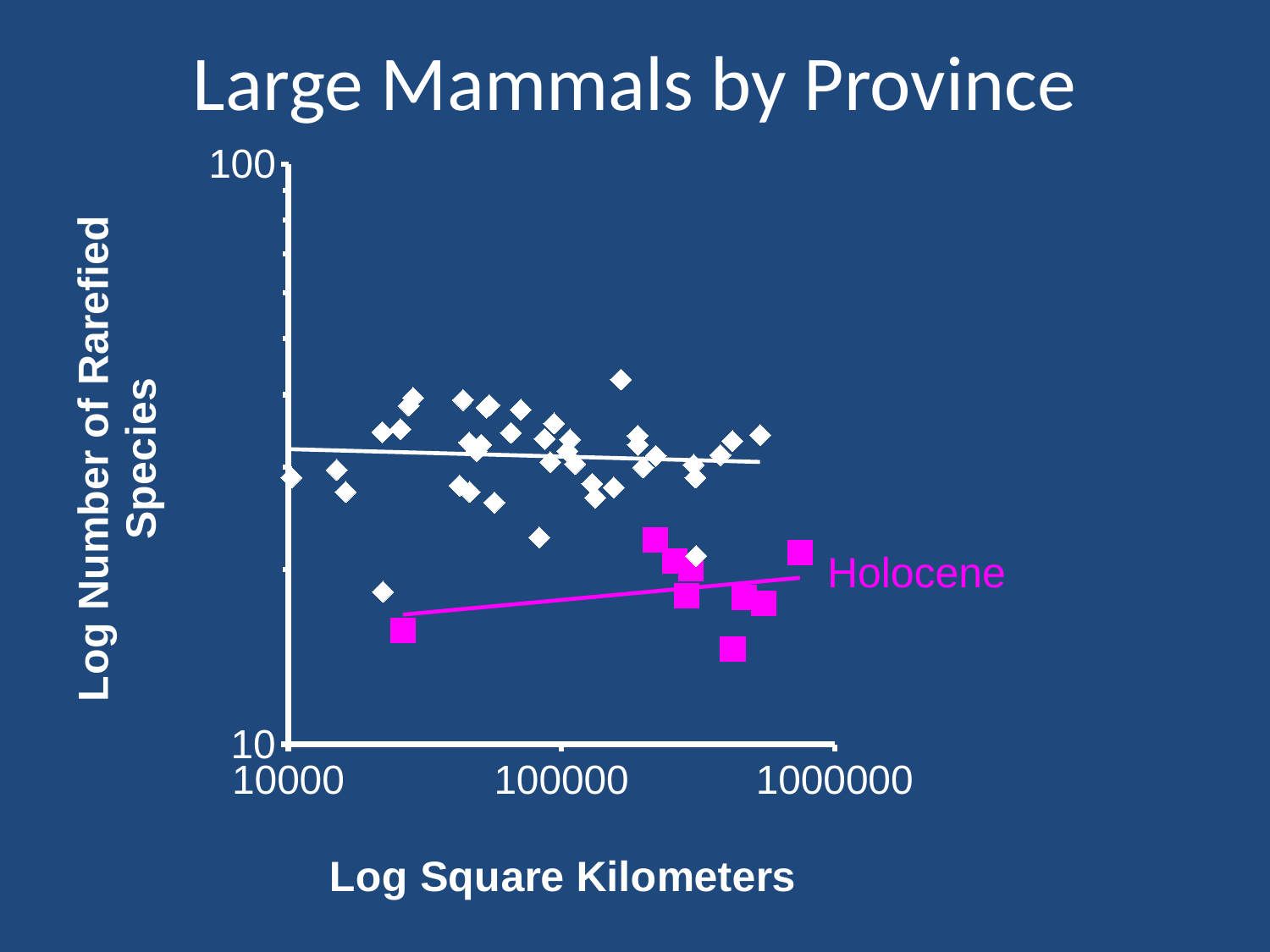
What is the label of the x axis? Log Square Kilometers What is the highest tick value shown on the y axis? 100 Is the value of the leftmost Holocene point greater or less than 100? less Which series is labeled on the chart with the magenta squares? Holocene What kind of chart is shown on the slide? scatter plot Which series generally has higher values on the y axis, the white diamonds or the magenta Holocene squares? white diamonds What is the lowest tick value shown on the x axis? 10000 Are all the plotted points greater or less than 10 on the y axis? greater What is the title of the chart? Large Mammals by Province Is the highest white diamond point greater or less than 100 on the y axis? less Does the Holocene trend line rise or fall as Log Square Kilometers increases? rise